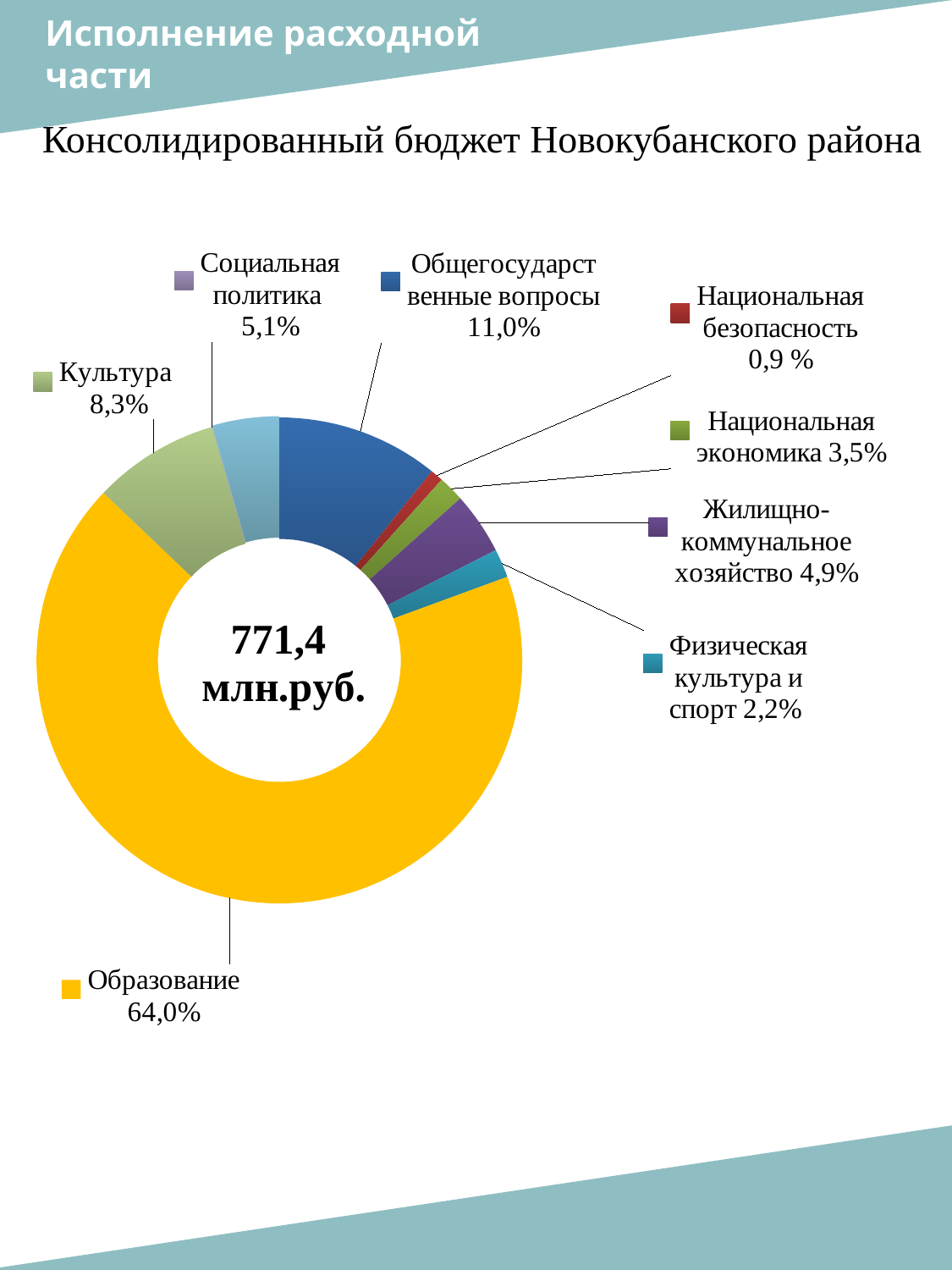
What share is labelled for Культура? 8,3% Which has a larger share: Социальная политика or Национальная экономика? Социальная политика Which category has the smallest share of the budget? Национальная безопасность How many categories are shown in the chart? 8 Which category has the largest share of the budget? Образование What share of the consolidated budget expenditure goes to Образование? 64,0% What share is shown for Национальная безопасность? 0,9 % What percentage is shown for Жилищно-коммунальное хозяйство? 4,9% What type of chart is shown on the slide? Doughnut (pie) chart What percentage is shown for Общегосударственные вопросы? 11,0% What total amount is printed in the centre of the chart? 771,4 млн.руб. What is the difference in percentage points between Общегосударственные вопросы and Культура? 2,7